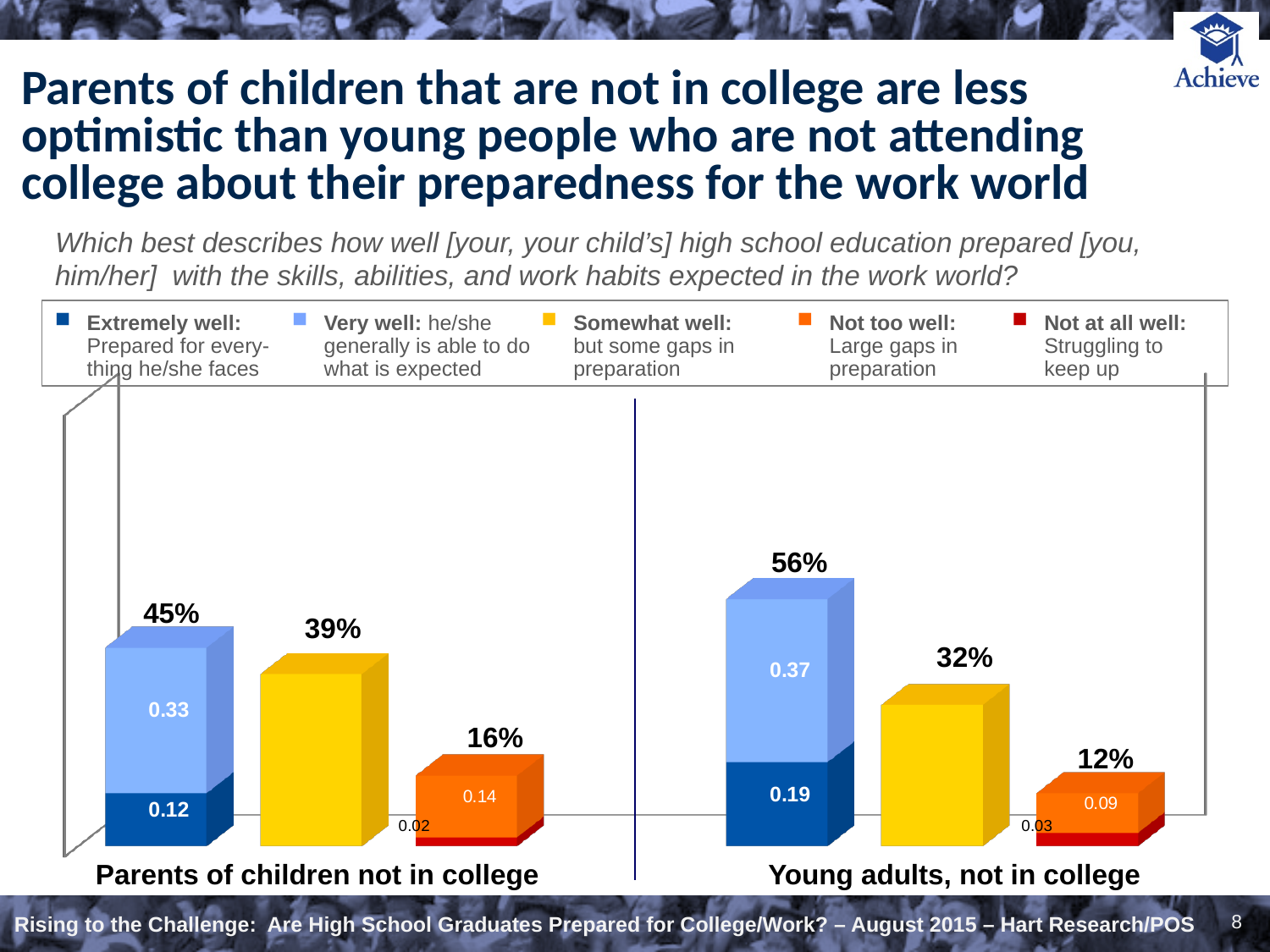
What is the value labeled for 'Not at all well' among young adults, not in college? 0.03 Which group has the higher combined 'Not too well' plus 'Not at all well' total? Parents of children not in college What is the value labeled for 'Very well' among young adults, not in college? 0.37 What is the value labeled for 'Extremely well' among parents of children not in college? 0.12 What is the total shown above the 'Extremely well' plus 'Very well' stacked bar for young adults, not in college? 56% How many response categories does the legend list? 5 What is the value labeled for 'Not too well' among parents of children not in college? 0.14 Which group has the higher combined 'Extremely well' plus 'Very well' total: parents of children not in college or young adults, not in college? Young adults, not in college What percentage of parents of children not in college answered 'Somewhat well'? 39% What kind of chart is shown on the slide? bar chart How many respondent groups are shown along the x axis? 2 What is the difference between the 'Somewhat well' percentages for parents of children not in college and young adults, not in college? 7 percentage points